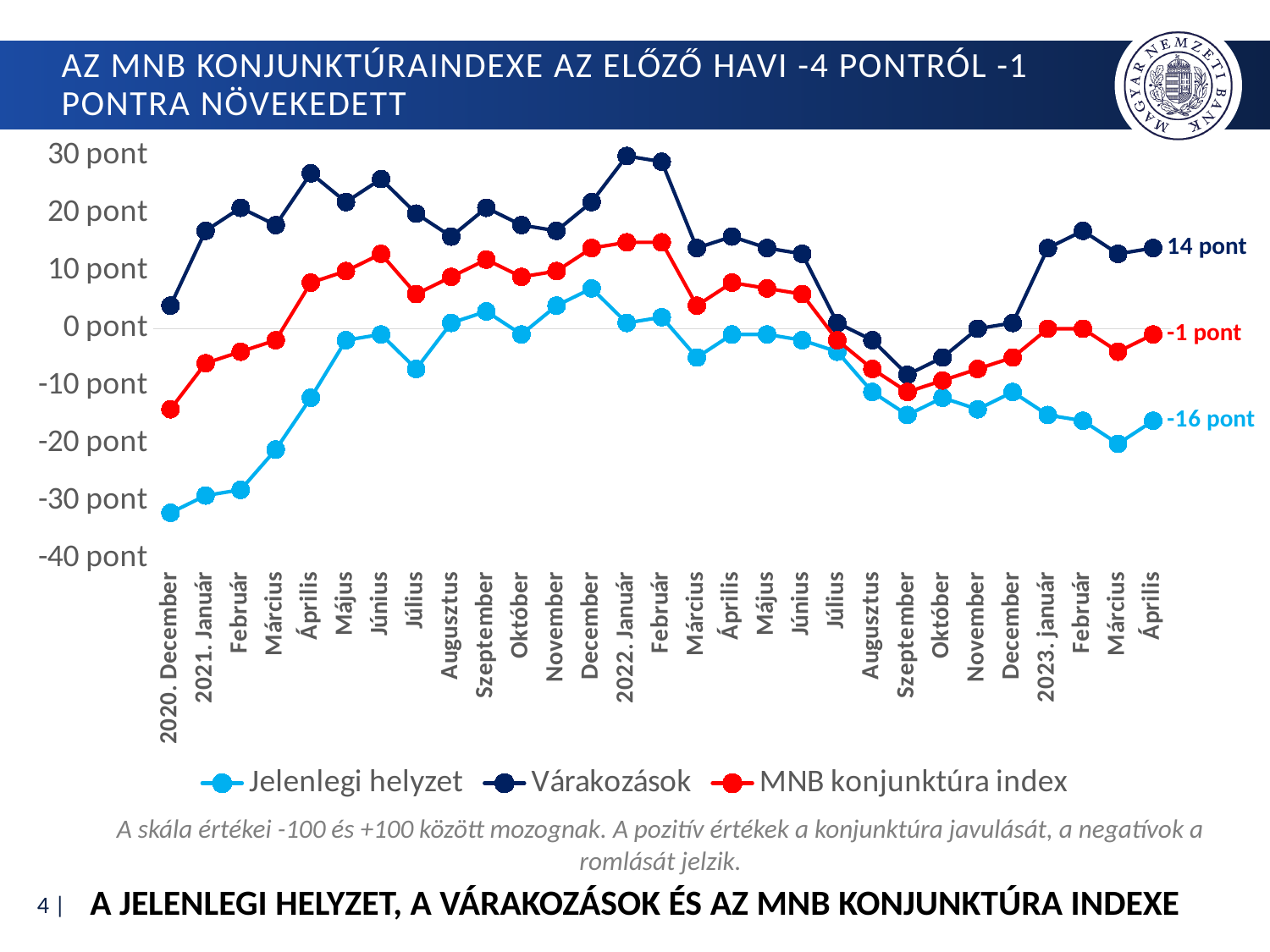
Is the value of Jelenlegi helyzet in 2021 Március greater or less than -10 pont? less What is the value of the Jelenlegi helyzet series in 2023 Április? -16 pont What is the difference between Várakozások and Jelenlegi helyzet in 2023 Április? 30 pont What is the value of the MNB konjunktúra index in 2023 Április? -1 pont How many months are plotted along the x axis? 29 Which series has the highest value in 2023 Április? Várakozások What is the difference between Várakozások and the MNB konjunktúra index in 2023 Április? 15 pont In 2023 Április, which is larger: Várakozások or Jelenlegi helyzet? Várakozások How many series does the legend list? 3 What kind of chart is shown on the slide? Line chart What is the value of the Várakozások series in 2023 Április? 14 pont Is the value of Várakozások in 2022. Január greater or less than 20 pont? greater